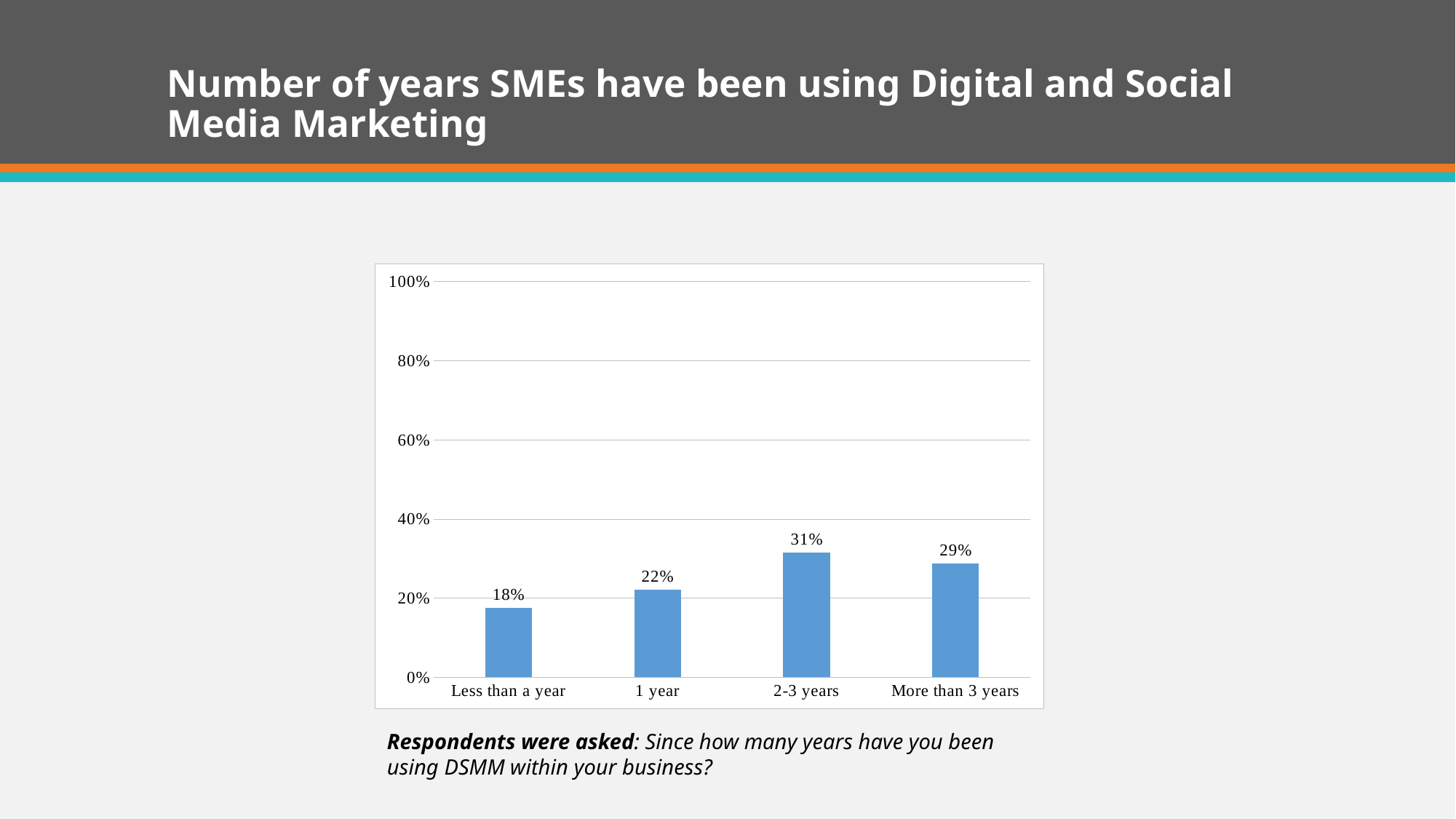
How many categories are shown on the x axis? 4 What is the difference between the values for '2-3 years' and 'Less than a year'? 13% Which is larger, the value for '1 year' or the value for 'More than 3 years'? More than 3 years Which category has the highest value? 2-3 years What is the value shown for the 'More than 3 years' category? 29% What is the highest value shown on the y axis? 100% What kind of chart is shown on the slide? Bar chart What is the value shown for the '2-3 years' category? 31% Is the value for '2-3 years' greater or less than 40%? less What is the value shown for the '1 year' category? 22% What percentage of SMEs have been using Digital and Social Media Marketing for less than a year? 18% Which category has the lowest value? Less than a year